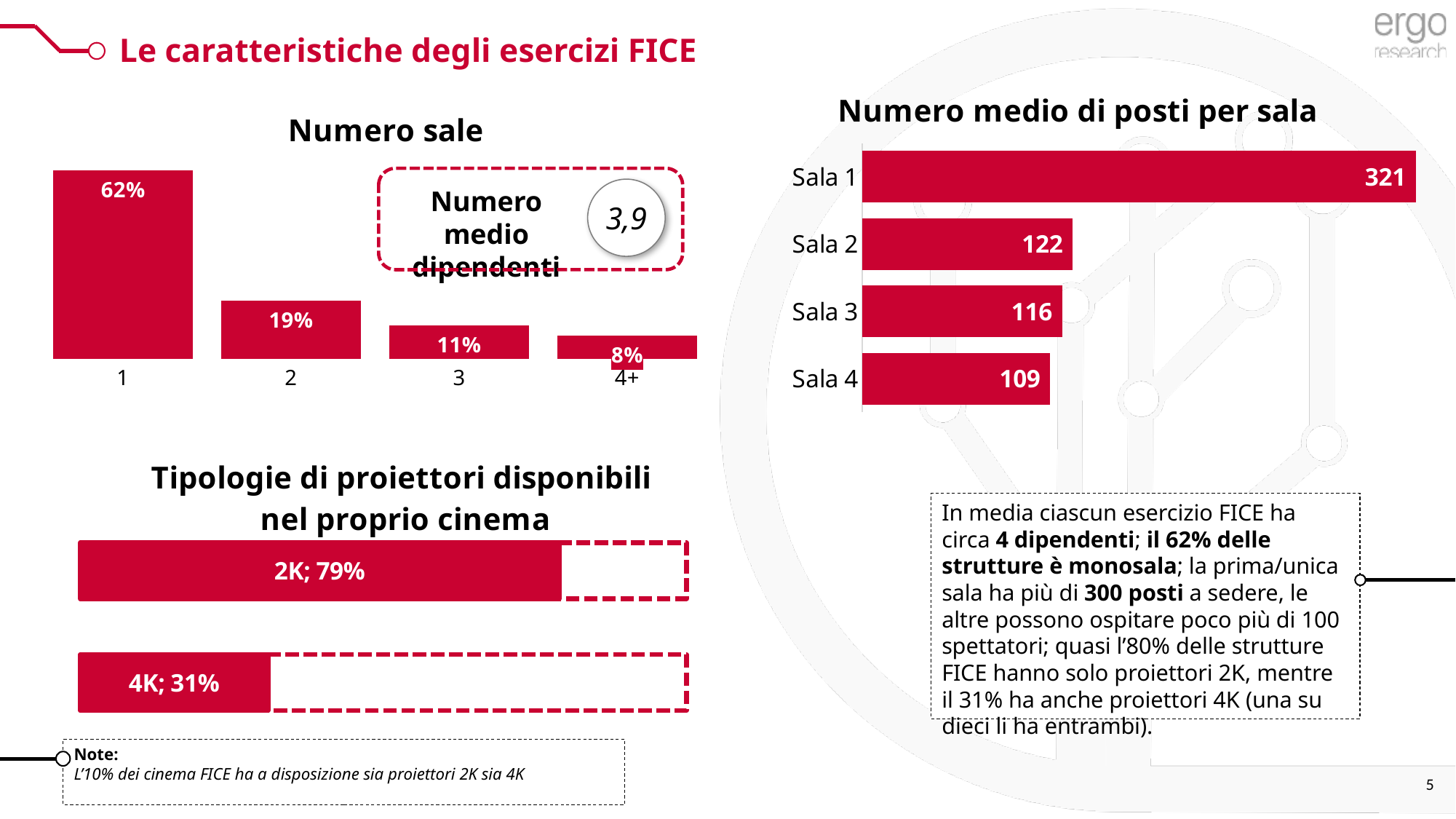
In the 'Numero sale' chart, do the values rise or fall from category 1 to category 4+? fall In the 'Numero sale' chart, how many categories are shown on the x axis? 4 In the 'Numero sale' chart, what percentage is shown for category 1? 62% In the 'Tipologie di proiettori disponibili nel proprio cinema' chart, which is larger, 2K or 4K? 2K In the 'Numero sale' chart, which category has the highest value? 1 In the 'Numero medio di posti per sala' chart, what is the difference between Sala 1 and Sala 2? 199 In the 'Numero medio di posti per sala' chart, what is the value for Sala 3? 116 In the 'Numero medio di posti per sala' chart, which sala has the lowest value? Sala 4 In the 'Numero sale' chart, what is the difference between the values for category 1 and category 2? 43% What kind of chart is 'Numero medio di posti per sala'? bar chart In the 'Numero sale' chart, what percentage is shown for category 4+? 8% In the 'Numero medio di posti per sala' chart, what is the value for Sala 1? 321